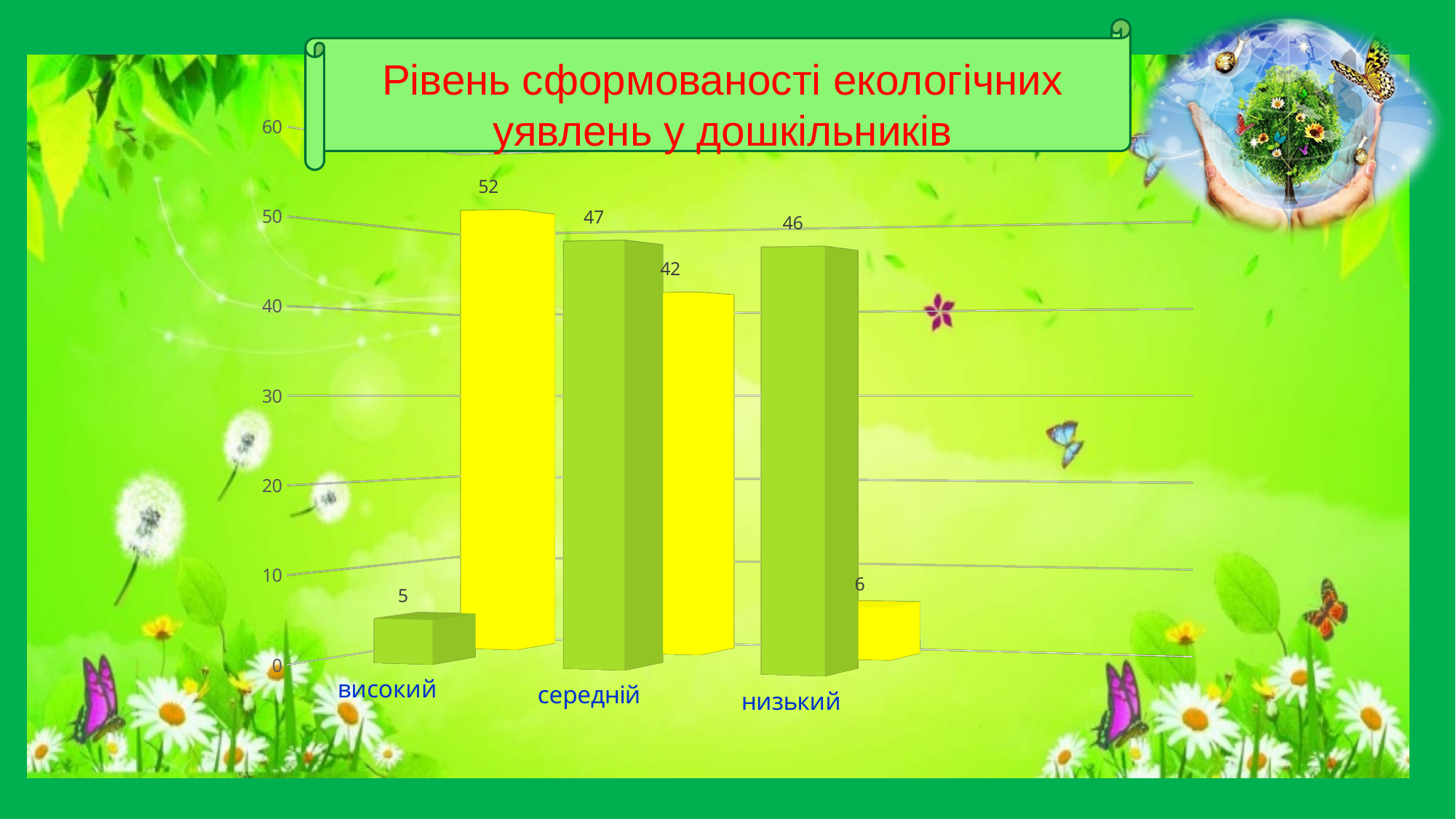
Which category has the lowest green bar? високий How many categories are shown on the x axis of the chart? 3 What is the value of the green bar for the category "високий"? 5 What is the value of the green bar for the category "середній"? 47 For the category "низький", which bar is larger, the green one or the yellow one? green What type of chart is shown on the slide? bar chart What is the title of the chart on the slide? Рівень сформованості екологічних уявлень у дошкільників What is the difference between the yellow bar for "високий" and the yellow bar for "низький"? 46 What is the difference between the green and yellow bars for the category "середній"? 5 What is the value of the yellow bar for the category "низький"? 6 What is the value of the yellow bar for the category "високий"? 52 Which category has the highest yellow bar? високий